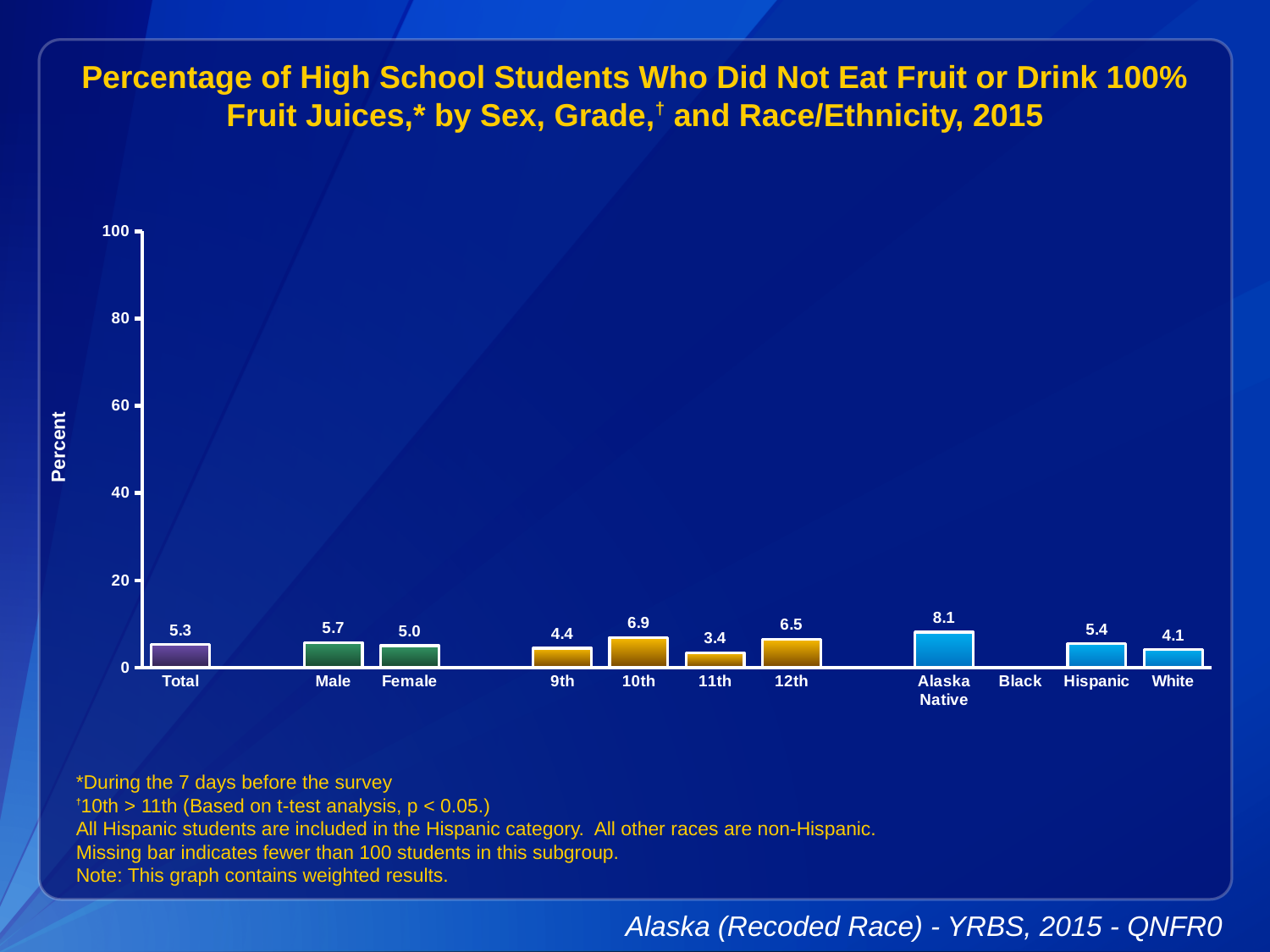
What is the value for Total? 5.3 What kind of chart is shown on the slide? bar chart What is the label on the vertical axis? Percent Which category has no bar shown? Black Which category has the lowest value among the bars shown? 11th Which is larger, the value for 10th grade or the value for 12th grade? 10th What is the difference between the values for Male and Female? 0.7 Which category has the highest value? Alaska Native Is the value for Hispanic students greater or less than 20? less How many categories have a bar plotted on the chart? 10 What is the value for Alaska Native students? 8.1 What is the value for 11th grade students? 3.4